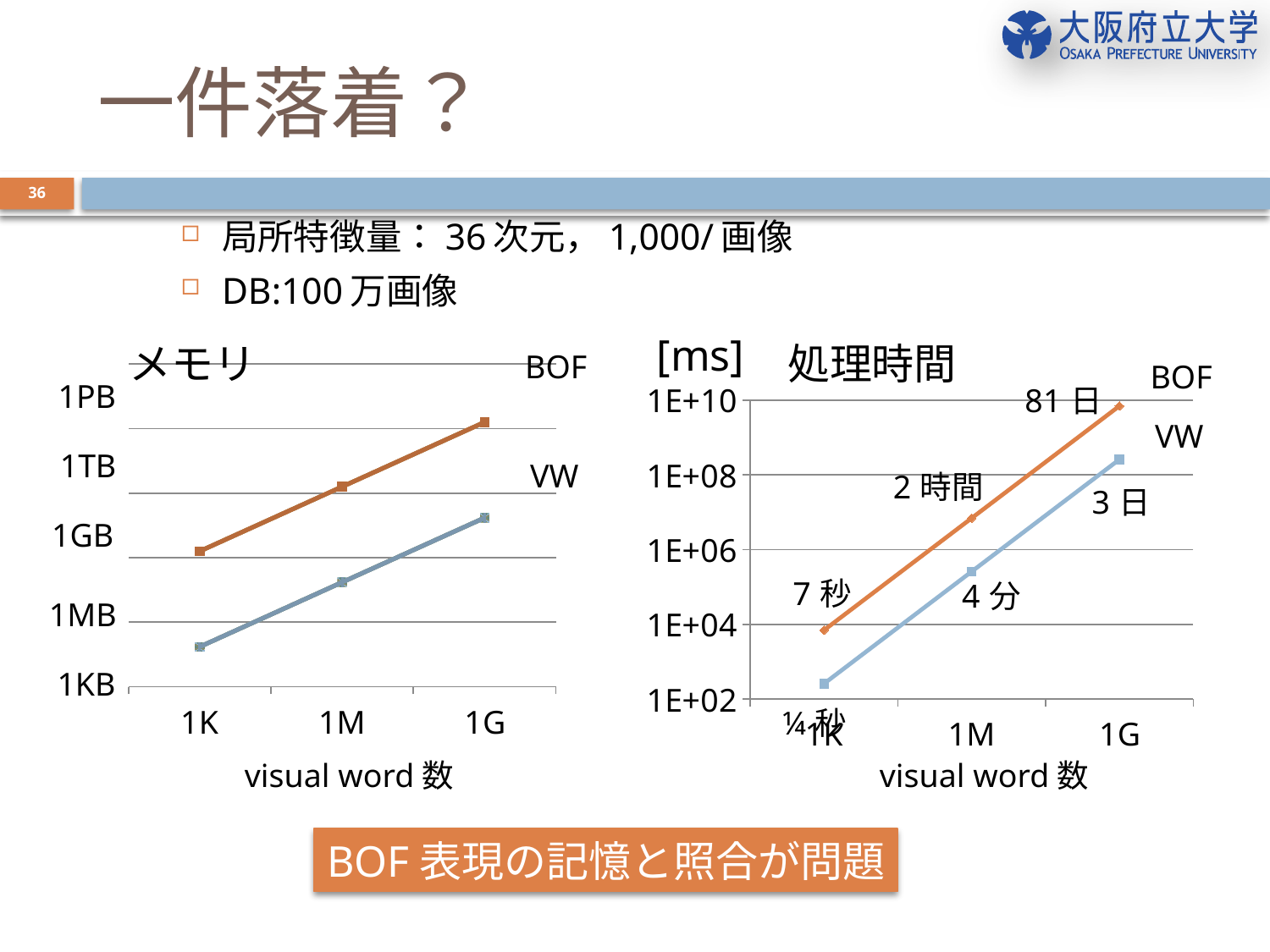
In the 処理時間 chart, what label is printed next to the VW point at 1G? 3 日 What kind of chart is the メモリ chart on the left? line chart In the 処理時間 chart, what label is printed next to the VW point at 1M? 4 分 In the メモリ chart, which series has the larger value at 1M, BOF or VW? BOF In the 処理時間 chart, what label is printed next to the BOF point at 1K? 7 秒 In the 処理時間 chart, do the values rise or fall as the number of visual words increases? rise How many series are shown in the 処理時間 chart on the right? 2 How many visual word counts are plotted along the x axis of the メモリ chart? 3 In the メモリ chart, is the BOF value at 1G greater or less than 1TB? greater In the 処理時間 chart, is the VW value at 1K greater or less than 1E+04? less In the 処理時間 chart, what label is printed next to the BOF point at 1G? 81 日 In the メモリ chart, is the VW value at 1K greater or less than 1MB? less